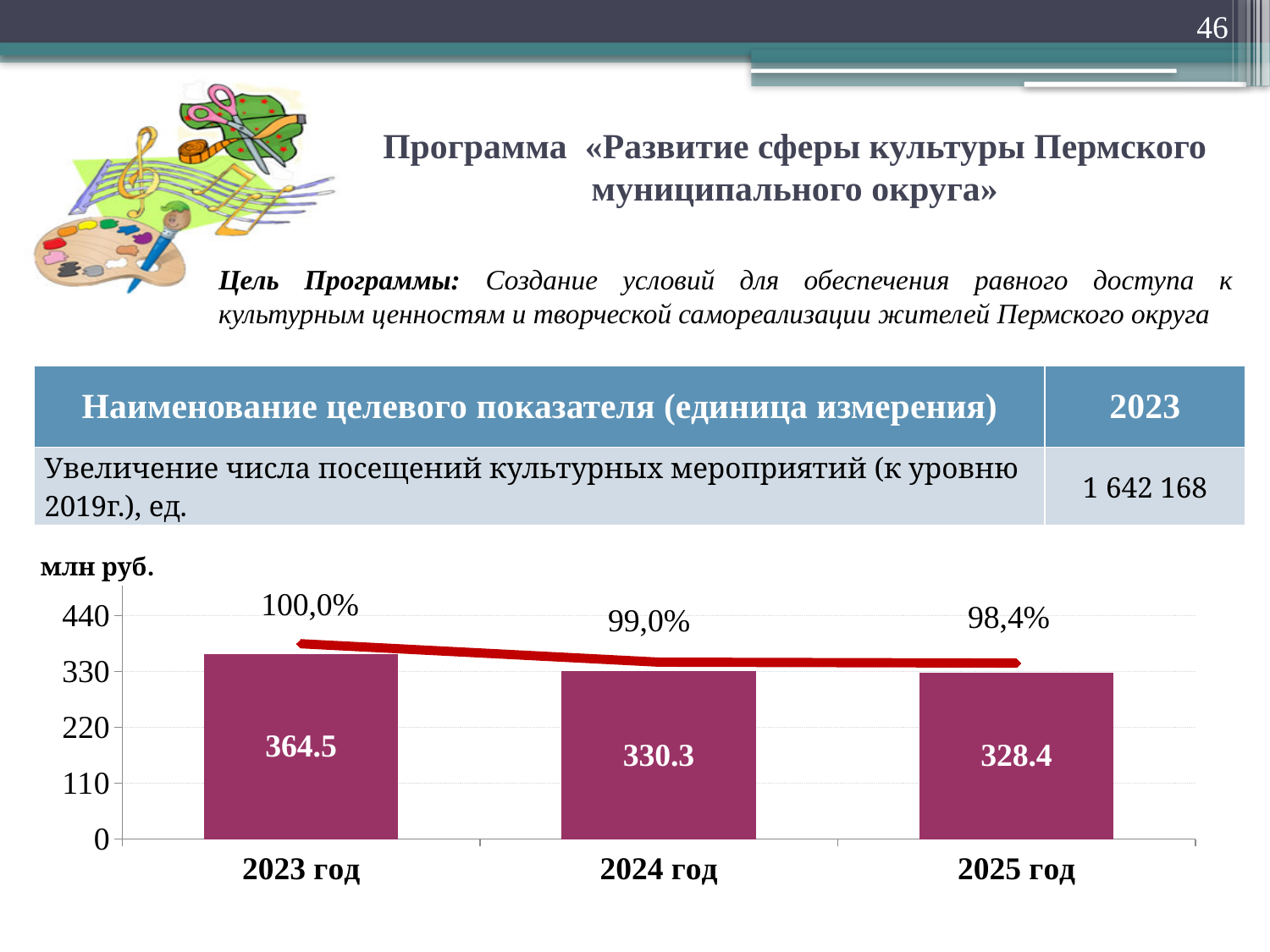
What is the value for 2025 год in the bar chart? 328.4 Is the value for 2023 год greater or less than 330? greater How many years are shown on the x axis of the chart? 3 What kind of chart is shown on the slide? combination bar and line chart Do the bar values rise or fall from 2023 год to 2025 год? fall Which year has the highest bar in the chart? 2023 год What is the value for 2023 год in the bar chart? 364.5 Which is larger, the value for 2024 год or the value for 2025 год? 2024 год What is the difference between the values for 2023 год and 2024 год? 34.2 What is the value for 2024 год in the bar chart? 330.3 What percentage label is shown above the 2025 год bar? 98,4% Which year has the lowest bar in the chart? 2025 год